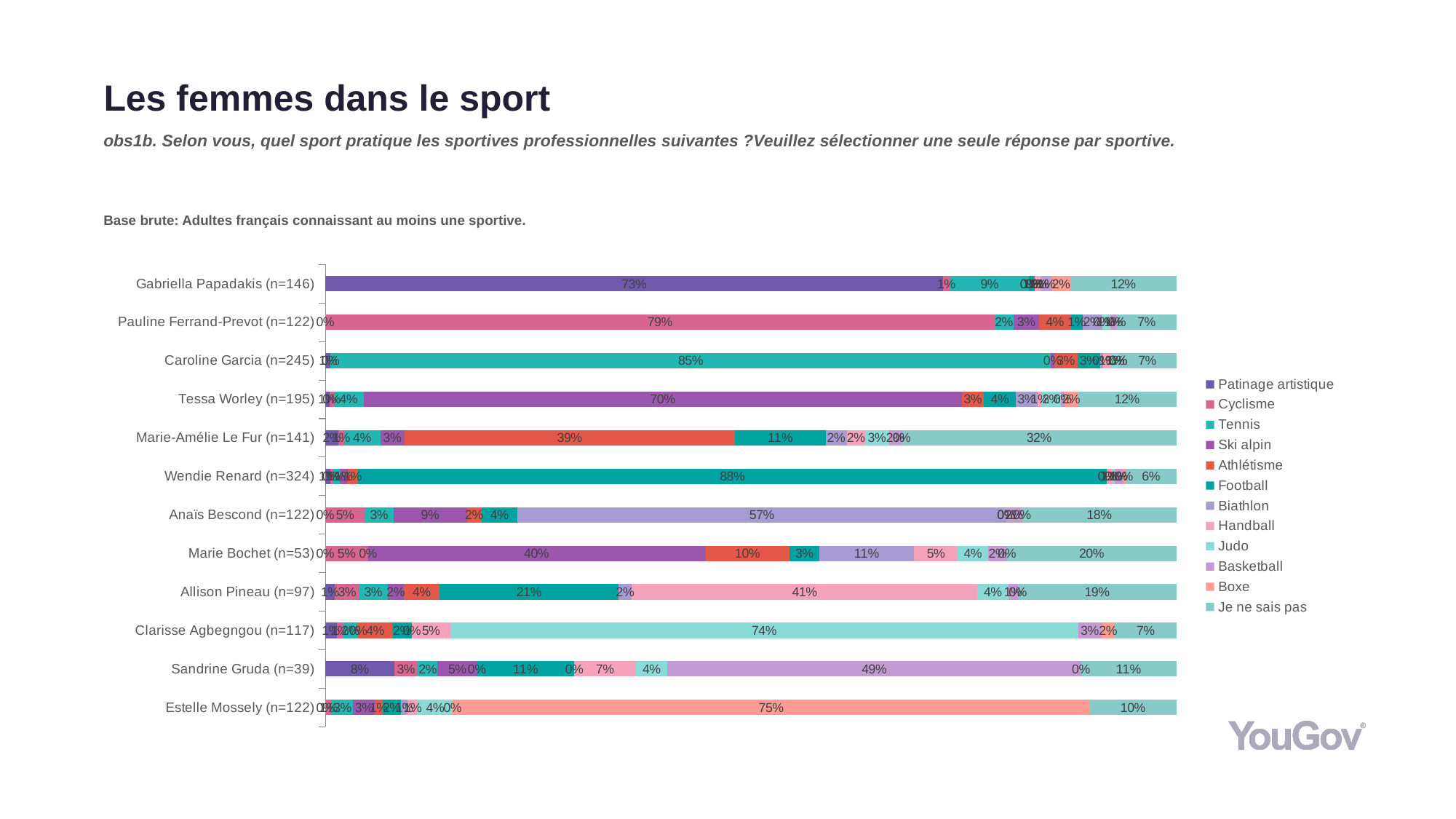
Which is larger: the Cyclisme value for Pauline Ferrand-Prevot or the Ski alpin value for Tessa Worley? Cyclisme value for Pauline Ferrand-Prevot Which athlete has the highest 'Je ne sais pas' value? Marie-Amélie Le Fur (n=141) Which series is listed last in the legend? Je ne sais pas What is the Tennis value for Caroline Garcia? 85% What is the difference between the Boxe value for Estelle Mossely and the Judo value for Clarisse Agbegngou? 1% What percentage of respondents associated Gabriella Papadakis with Patinage artistique? 73% What is the Football value for Wendie Renard? 88% How many athletes (categories) are listed on the chart? 12 What is the Handball value for Allison Pineau? 41% What kind of chart is shown on the slide? Stacked bar chart What is the Basketball value for Sandrine Gruda? 49% How many series does the legend list? 12